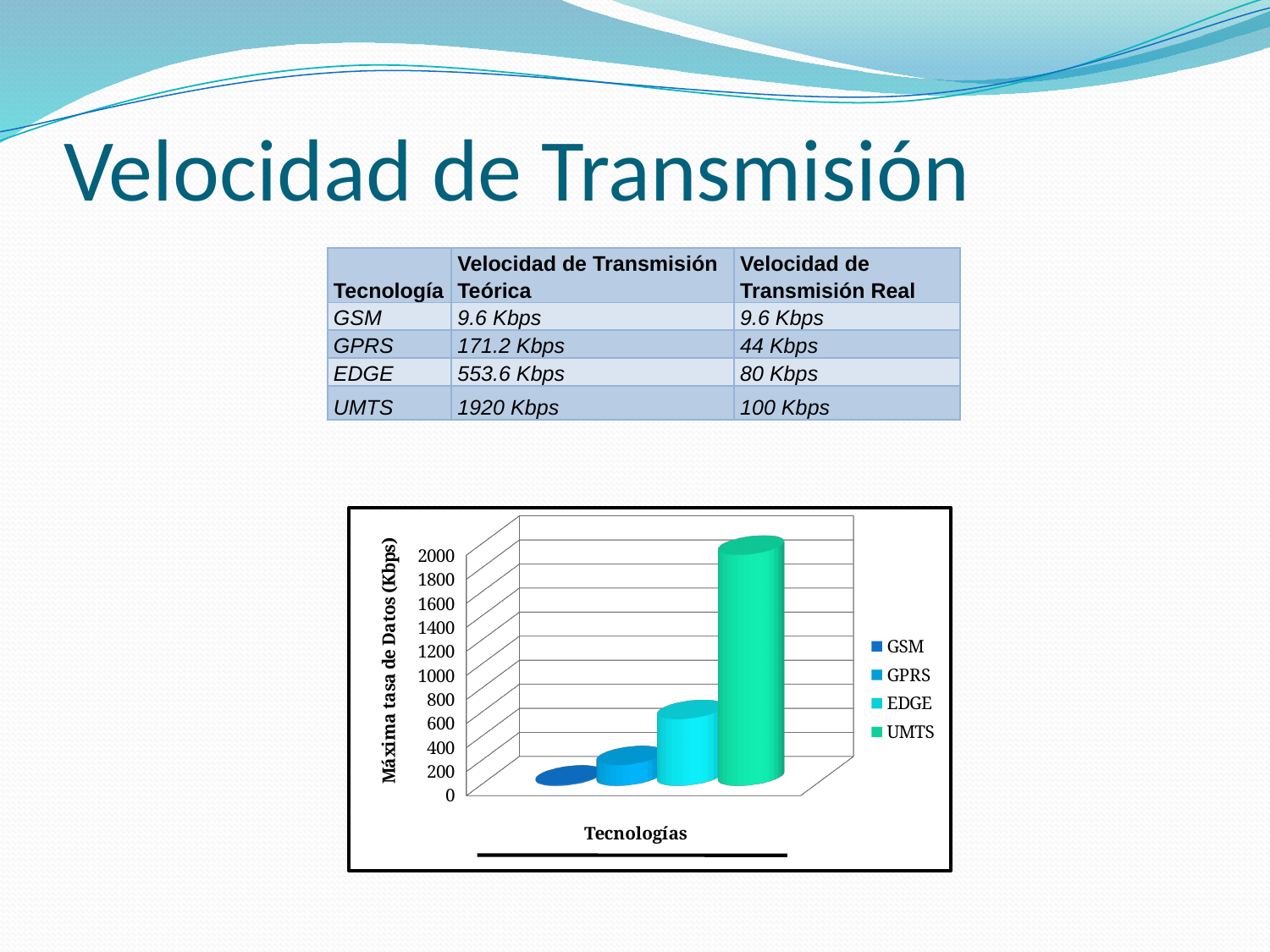
Is the bar for EDGE greater or less than 800? less Which bar is taller, EDGE or GPRS? EDGE How many bars are plotted in the chart? 4 Is the bar for GPRS greater or less than 400? less Do the bar heights rise or fall from GSM to UMTS along the x axis? rise Is the bar for UMTS greater or less than 1600? greater What is the label of the chart's vertical axis? Máxima tasa de Datos (Kbps) What is the label of the chart's horizontal axis? Tecnologías Which technology has the highest bar in the chart? UMTS What kind of chart is shown on the slide? bar chart Which technology has the lowest bar in the chart? GSM How many series does the chart legend list? 4